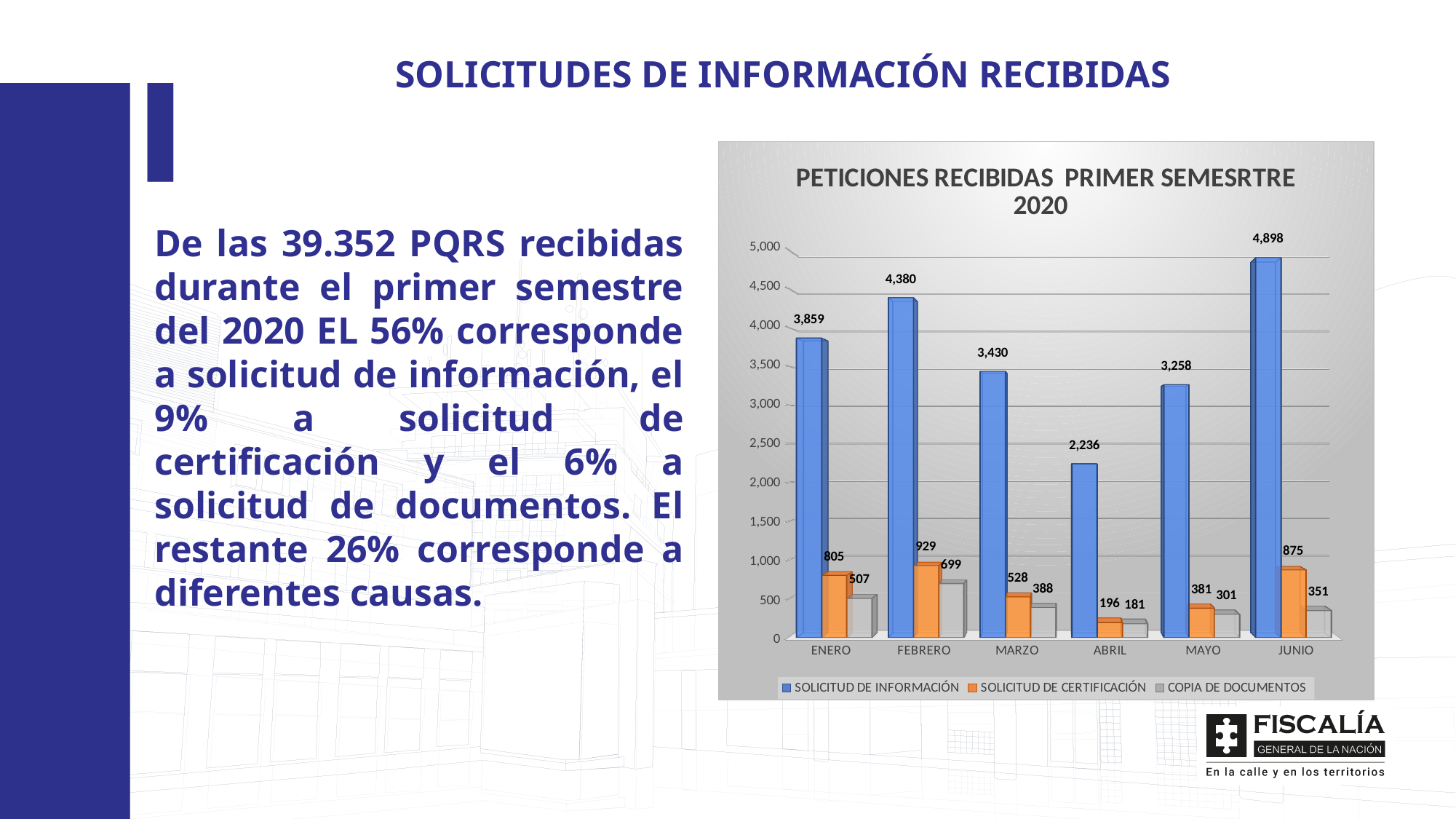
What is the title of the chart? PETICIONES RECIBIDAS PRIMER SEMESRTRE 2020 What is the difference between SOLICITUD DE INFORMACIÓN in FEBRERO and in ENERO? 521 What is the value for SOLICITUD DE CERTIFICACIÓN in FEBRERO? 929 What kind of chart is shown? bar chart Which month has the lowest value for SOLICITUD DE CERTIFICACIÓN? ABRIL Which month has the highest value for SOLICITUD DE INFORMACIÓN? JUNIO Is the value for SOLICITUD DE INFORMACIÓN in ABRIL greater or less than 2,500? less Which is larger: COPIA DE DOCUMENTOS in MARZO or in JUNIO? MARZO How many months are shown on the x axis? 6 What is the value for COPIA DE DOCUMENTOS in ABRIL? 181 How many series does the legend list? 3 What is the value for SOLICITUD DE INFORMACIÓN in JUNIO? 4,898